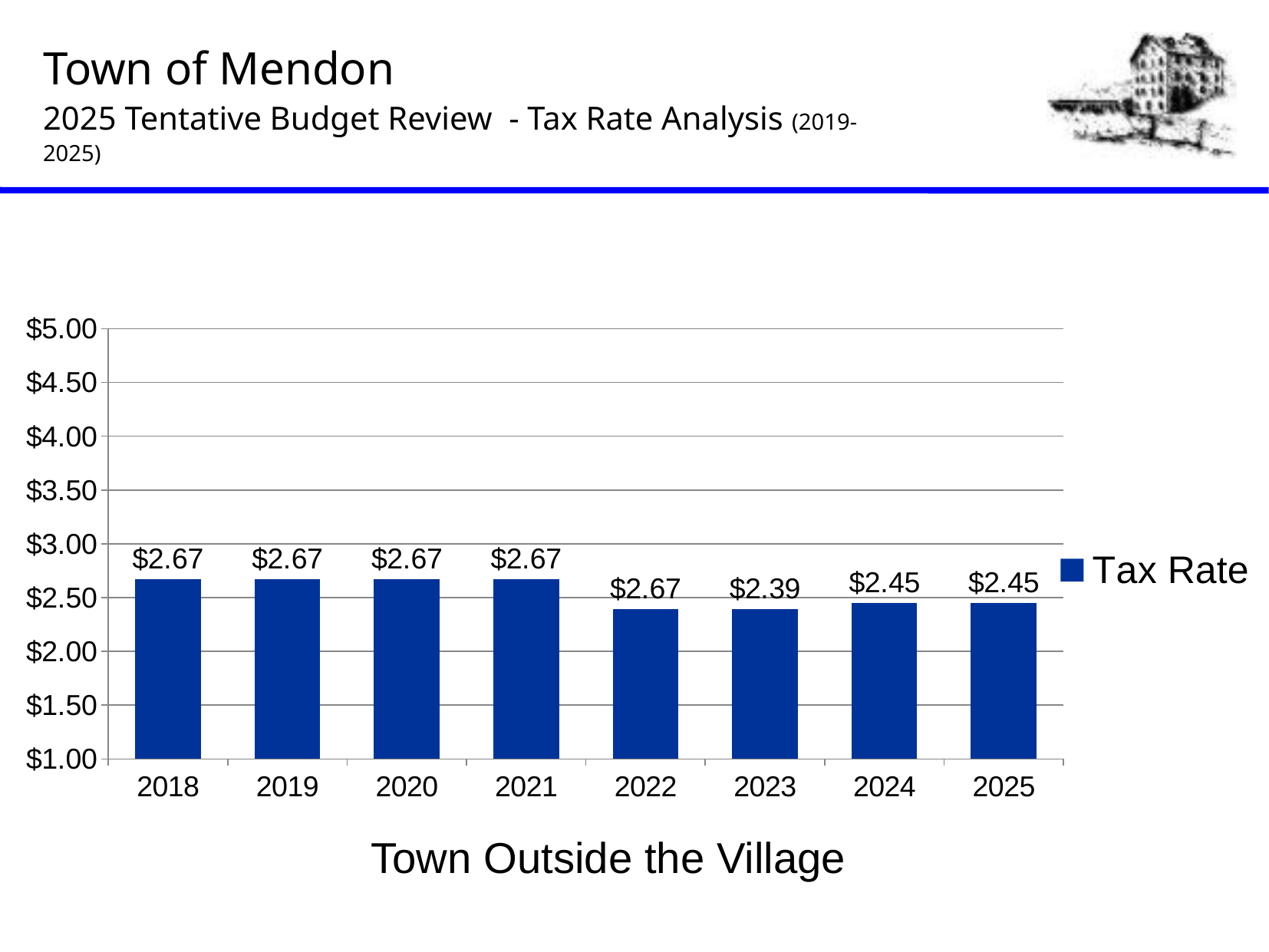
What is the tax rate shown for 2023? $2.39 What kind of chart is shown on the slide? bar chart What is the difference between the tax rate for 2021 and the tax rate for 2023? $0.28 What is the tax rate shown for 2025? $2.45 How many years are shown on the x axis of the chart? 8 What is the tax rate shown for 2021? $2.67 Is the tax rate for 2019 greater or less than $2.50? greater How many series does the chart's legend list? 1 What is the tax rate shown for 2018? $2.67 Which year has the larger tax rate, 2020 or 2024? 2020 What is the difference between the tax rate for 2024 and the tax rate for 2023? $0.06 Is the tax rate for 2023 greater or less than $2.50? less